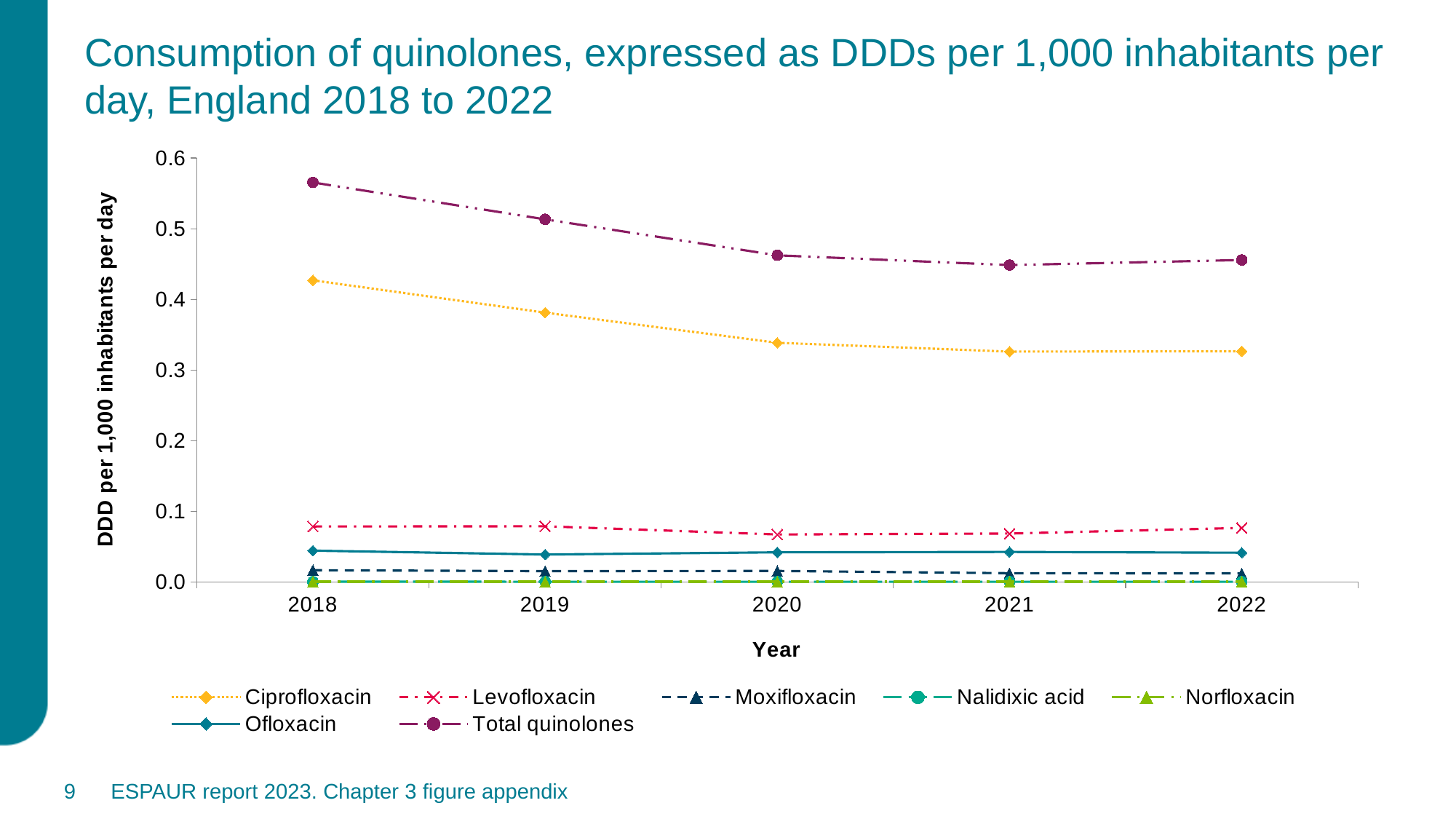
Does the Ciprofloxacin line rise or fall from 2018 to 2020? Fall Is the Total quinolones value for 2018 greater or less than 0.5? greater Is the Total quinolones value for 2021 greater or less than 0.5? less What is the label on the y axis? DDD per 1,000 inhabitants per day What kind of chart is shown on the slide? Line chart In which year is the Total quinolones value highest? 2018 Is the Ciprofloxacin value for 2018 greater or less than 0.4? greater How many years are plotted along the x axis? 5 Which is larger, the Ciprofloxacin value in 2018 or in 2019? 2018 How many series does the legend list? 7 Which series has the highest value in 2018? Total quinolones